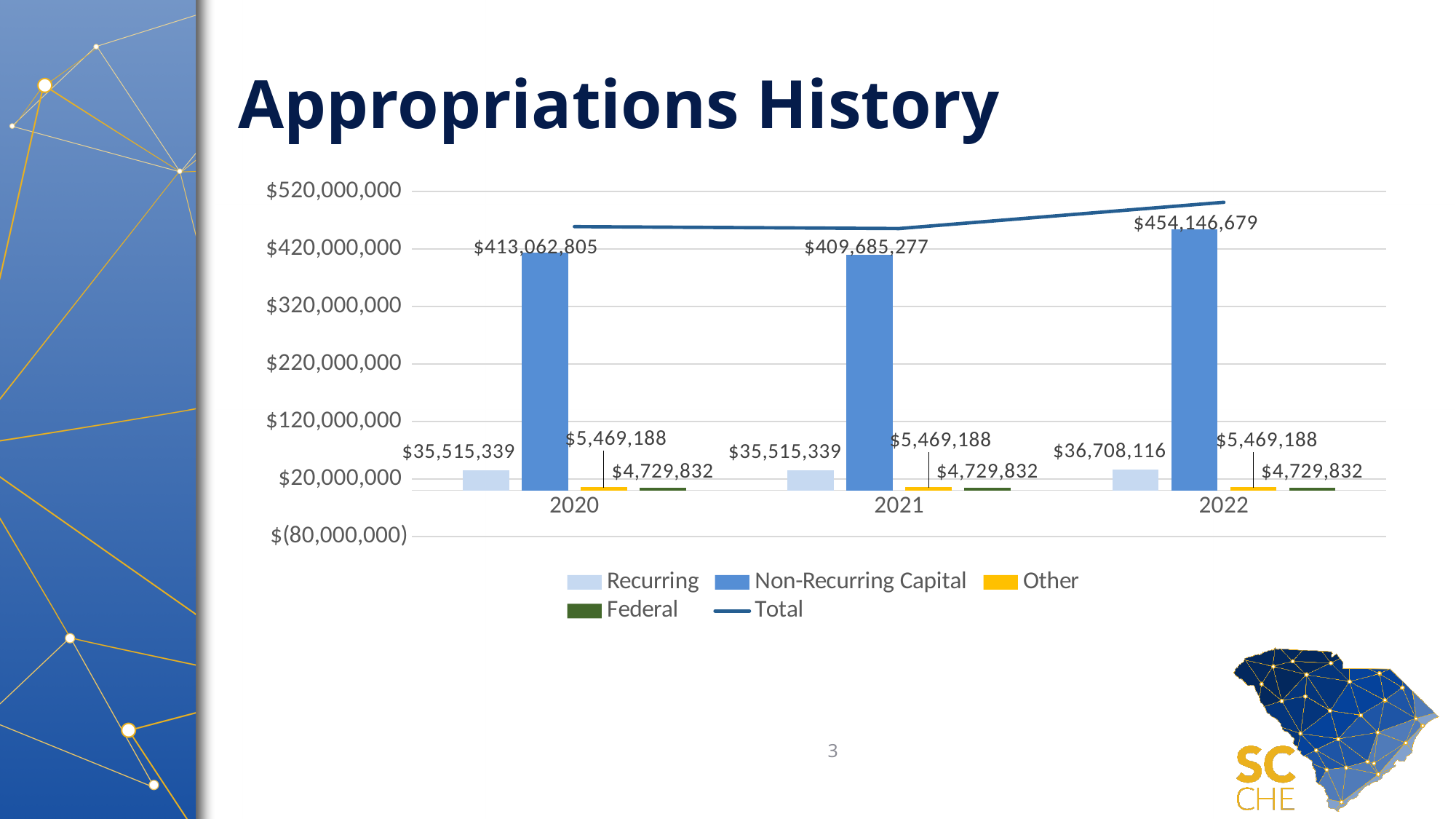
In which year is Non-Recurring Capital lowest? 2021 What is the value of Other for 2022? $5,469,188 What is the value of Federal for 2021? $4,729,832 What is the value of Recurring for 2020? $35,515,339 Is the Total line value for 2022 greater or less than $420,000,000? greater How many series does the legend list? 5 What is the difference between Non-Recurring Capital in 2022 and in 2021? $44,461,402 How many years are shown on the x axis? 3 Which is larger in 2020: Other or Federal? Other What is the value of Non-Recurring Capital for 2022? $454,146,679 What is the difference between Recurring in 2022 and in 2020? $1,192,777 In which year is Non-Recurring Capital highest? 2022